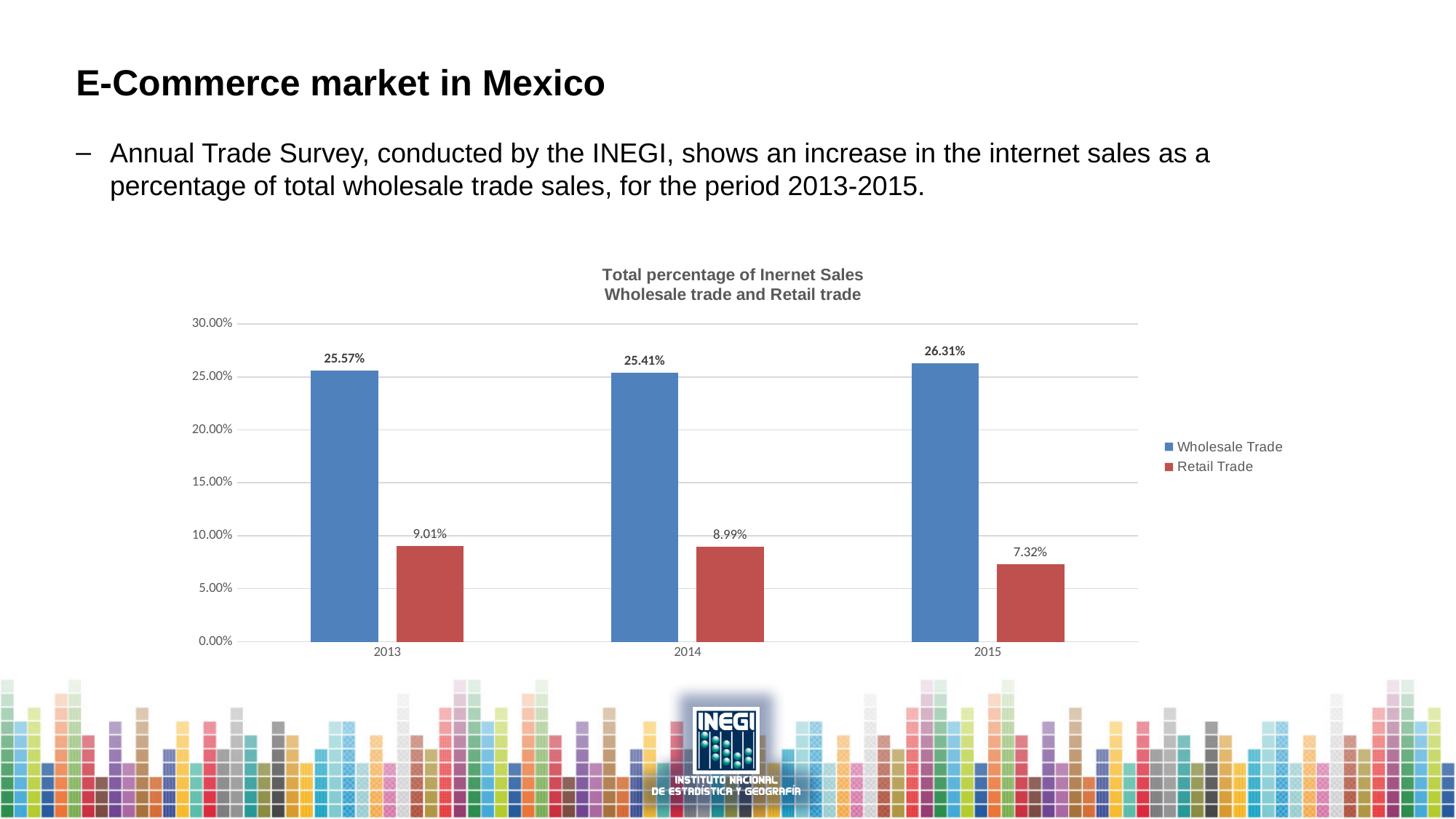
Which is larger in 2014: Wholesale Trade or Retail Trade? Wholesale Trade What is the Retail Trade value for 2014? 8.99% What kind of chart is shown on the slide? Bar chart In which year is the Retail Trade value lowest? 2015 How many series does the legend list? 2 What is the difference between the Retail Trade values for 2014 and 2015? 1.67% In which year is the Wholesale Trade value highest? 2015 Is the Retail Trade value for 2013 greater or less than 10.00%? less What is the Retail Trade value for 2015? 7.32% How many years are shown on the x axis? 3 What is the difference between the Wholesale Trade and Retail Trade values in 2013? 16.56% What is the Wholesale Trade value for 2013? 25.57%